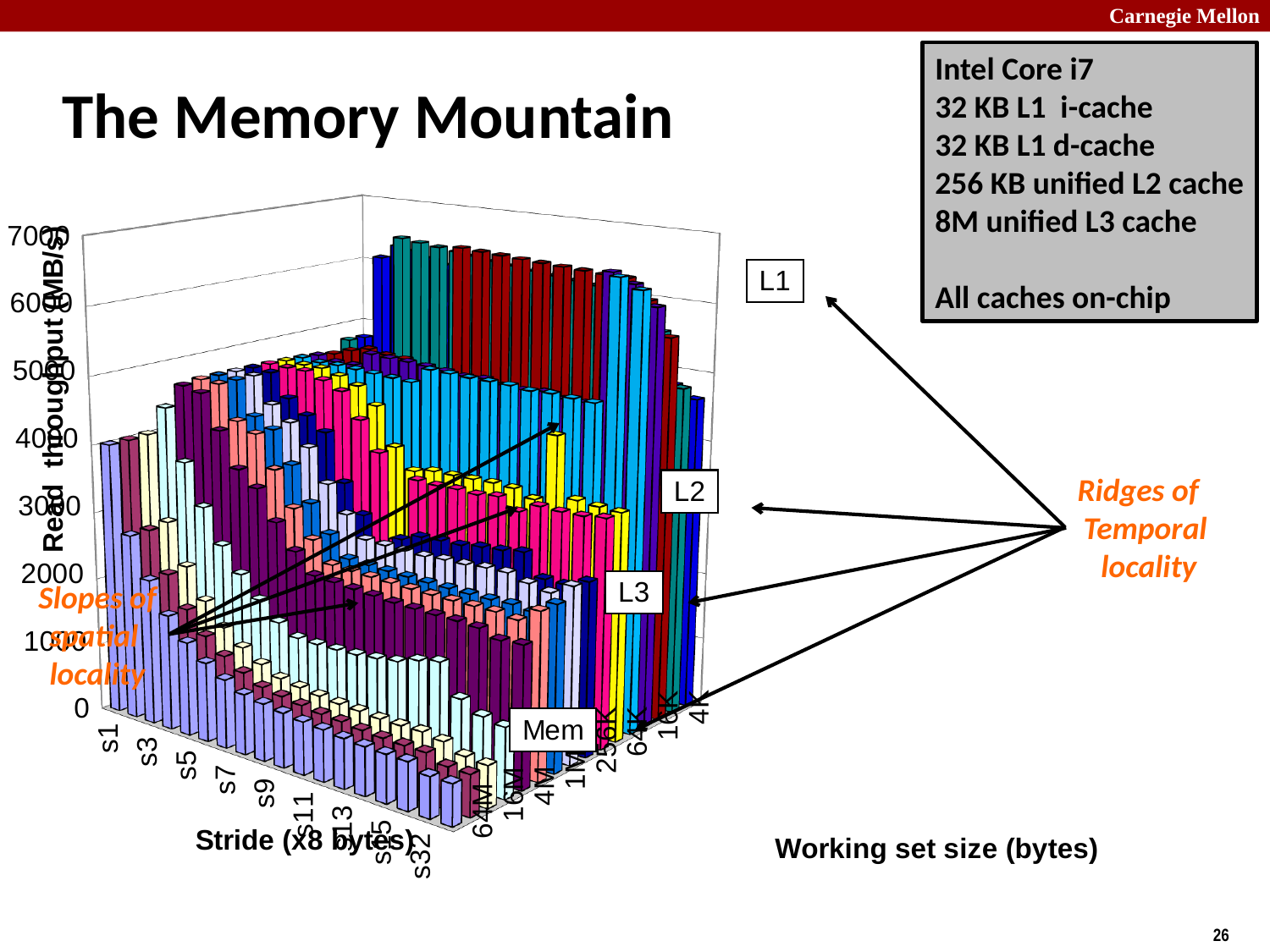
What is the title of the chart on the slide? The Memory Mountain What is the largest working set size labelled on the chart's working set size axis? 64M What kind of chart is shown on the slide? bar chart Is the read throughput for stride s32 at working set size 64M greater or less than 1000? less For working set size 64M, does read throughput rise or fall as the stride increases from s1 to s32? fall What is the smallest working set size labelled on the chart's working set size axis? 4K What quantity is plotted on the vertical axis of the chart? Read throughput (MB/s) Which working set size has the higher read throughput at stride s1: 4K or 64M? 4K Is the read throughput for the tallest bars in the L1 region greater or less than 6000? greater What is the highest tick value shown on the vertical axis of the chart? 7000 Which is larger: the read throughput at stride s1 with a 4K working set, or at stride s32 with a 64M working set? stride s1 with a 4K working set How many working set size labels are shown along the working set size axis? 8